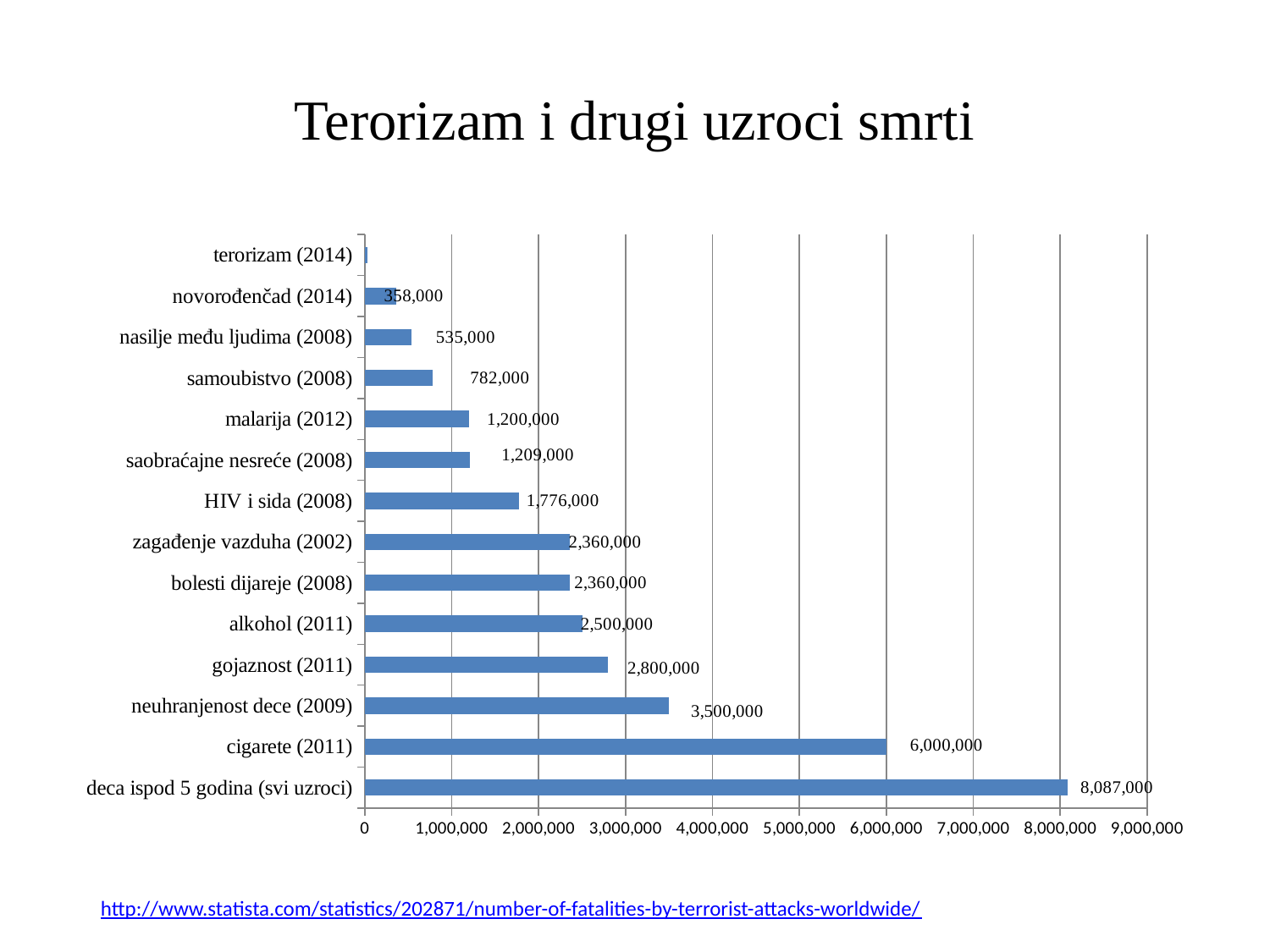
Which category has the highest value? deca ispod 5 godina (svi uzroci) Which category has the lowest value? terorizam (2014) What is the value for neuhranjenost dece (2009)? 3,500,000 What is the difference between the values for deca ispod 5 godina (svi uzroci) and cigarete (2011)? 2,087,000 What kind of chart is shown on the slide? bar chart How many categories are shown in the chart? 14 Which is larger, the value for gojaznost (2011) or the value for alkohol (2011)? gojaznost (2011) What is the value for cigarete (2011)? 6,000,000 What is the value for samoubistvo (2008)? 782,000 What is the value for HIV i sida (2008)? 1,776,000 What is the title of the slide? Terorizam i drugi uzroci smrti Is the value for terorizam (2014) greater or less than 1,000,000? less